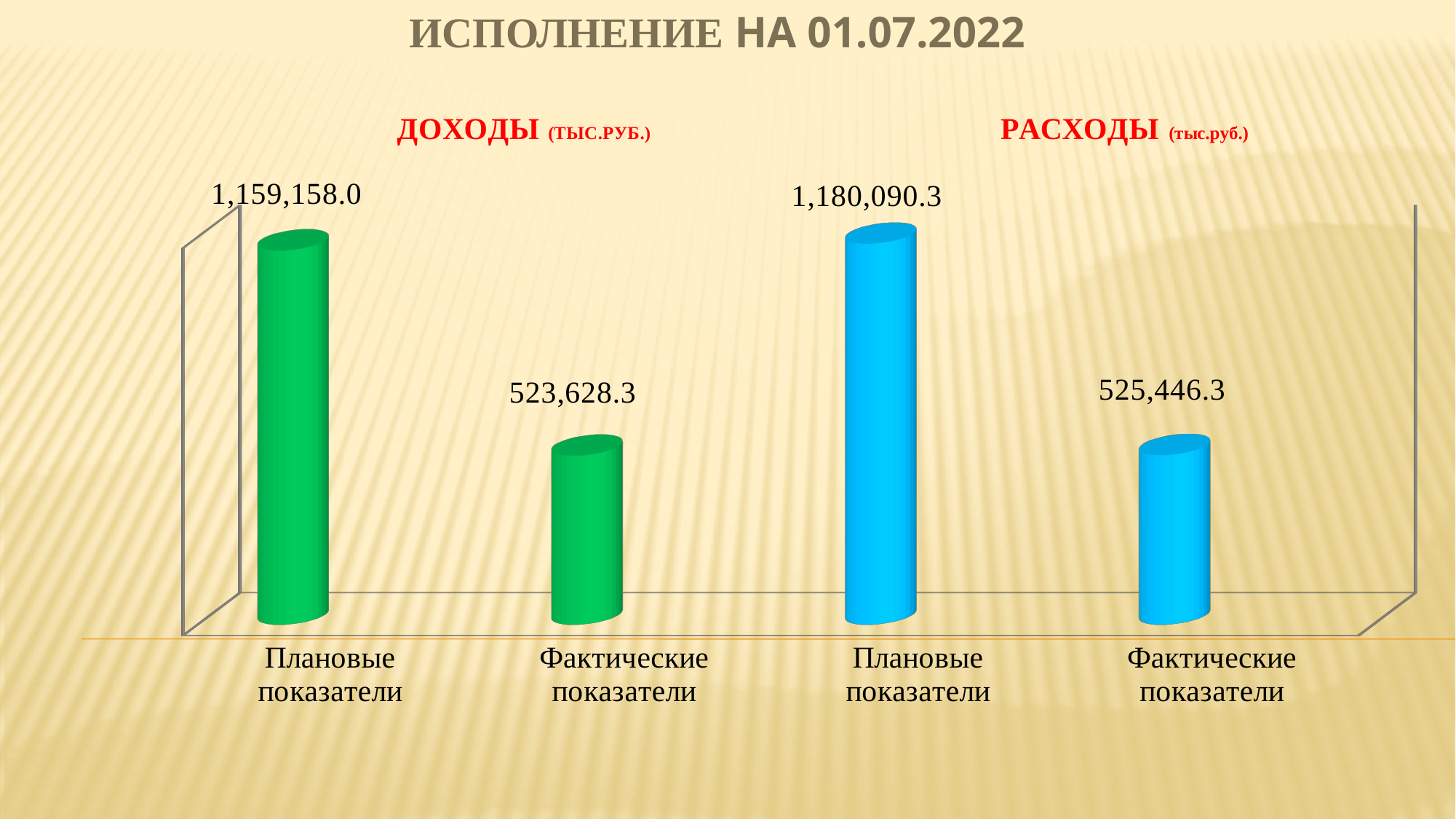
What colour are the bars under РАСХОДЫ? Blue What is the value of the planned indicators (Плановые показатели) bar under РАСХОДЫ? 1,180,090.3 What is the value of the actual indicators (Фактические показатели) bar under РАСХОДЫ? 525,446.3 What is the difference between the planned and actual indicators under ДОХОДЫ? 635,529.7 Which bar has the highest value on the chart? Плановые показатели under РАСХОДЫ (1,180,090.3) What is the difference between the planned and actual indicators under РАСХОДЫ? 654,644.0 What is the value of the actual indicators (Фактические показатели) bar under ДОХОДЫ? 523,628.3 Which bar has the lowest value on the chart? Фактические показатели under ДОХОДЫ (523,628.3) What type of chart is shown on the slide? Bar chart Which is larger: the planned indicators under ДОХОДЫ or the planned indicators under РАСХОДЫ? Плановые показатели under РАСХОДЫ How many bars are plotted on the chart? 4 What is the value of the planned indicators (Плановые показатели) bar under ДОХОДЫ? 1,159,158.0